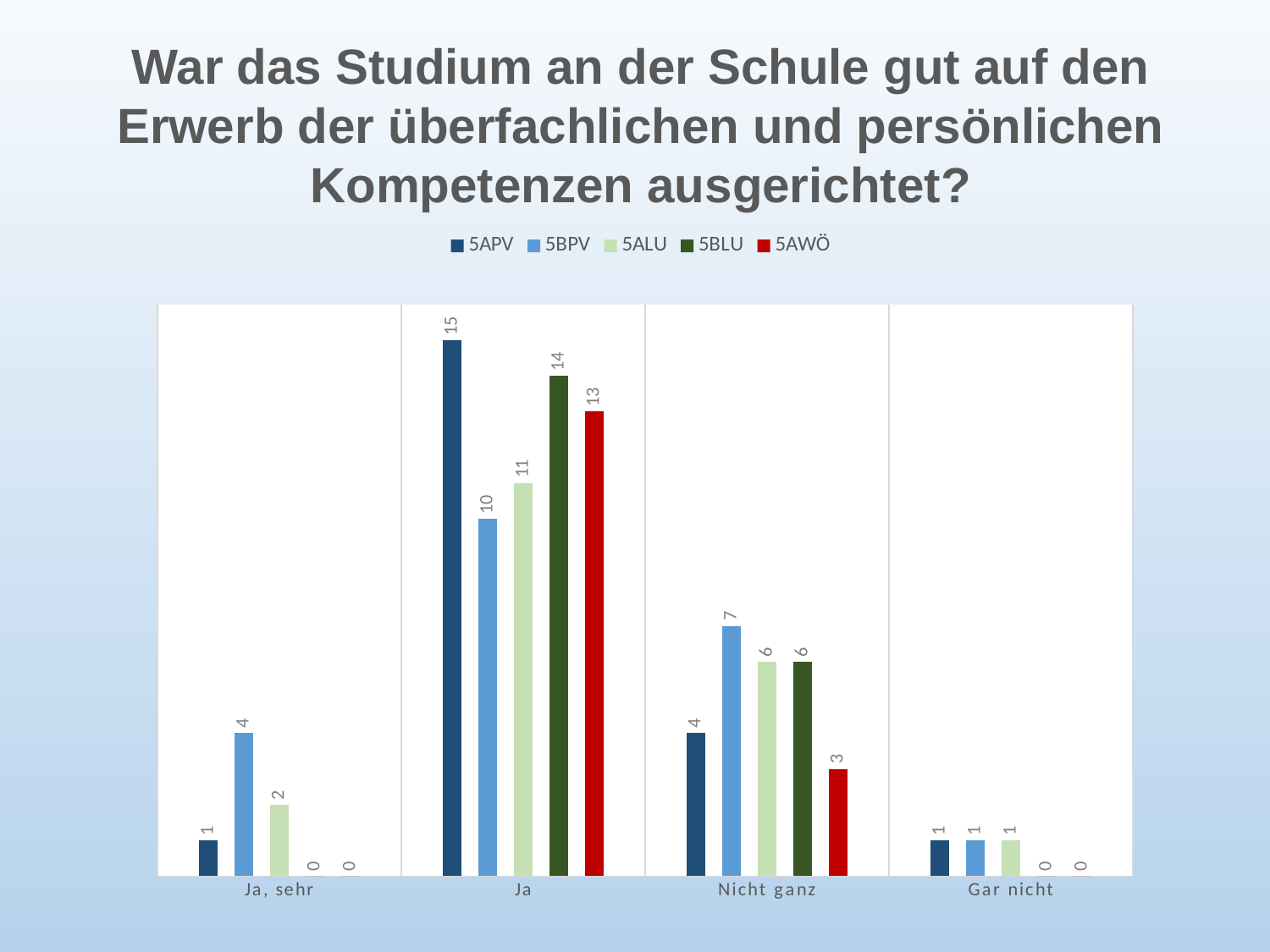
What kind of chart is shown on the slide? bar chart What is the value for 5APV in the "Ja" category? 15 Which series has the lowest value in the "Nicht ganz" category? 5AWÖ Which series is shown in red in the legend? 5AWÖ How many categories are shown on the x axis? 4 What is the value for 5BLU in the "Gar nicht" category? 0 What is the value for 5AWÖ in the "Nicht ganz" category? 3 What is the difference between the 5APV and 5BPV values in the "Ja" category? 5 Which series has the highest value in the "Ja" category? 5APV Which is larger: the 5BLU value for "Ja" or the 5AWÖ value for "Ja"? 5BLU How many series does the legend list? 5 What is the value for 5BPV in the "Ja, sehr" category? 4